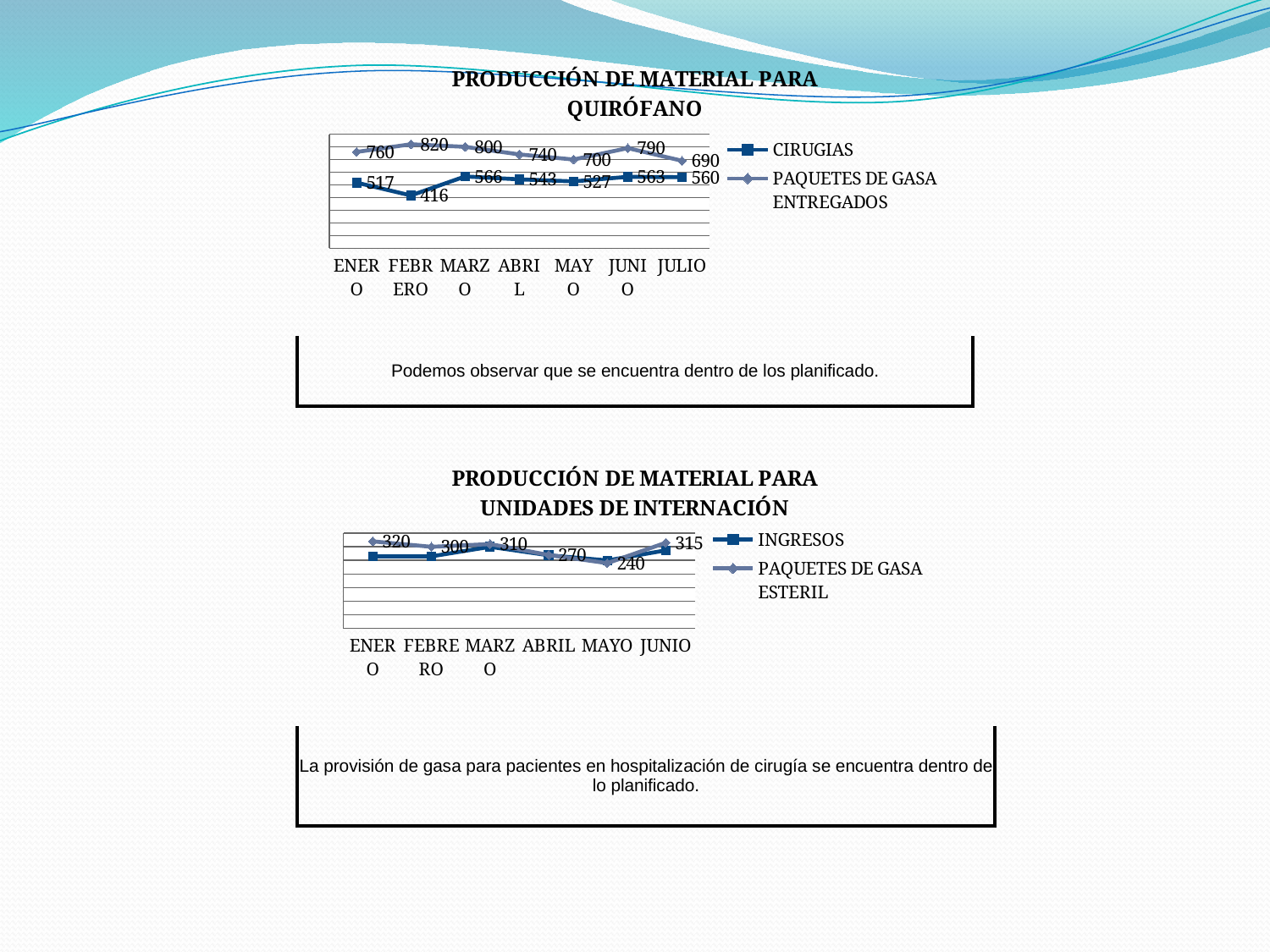
In the 'PRODUCCIÓN DE MATERIAL PARA QUIRÓFANO' chart, what is the value of PAQUETES DE GASA ENTREGADOS in FEBRERO? 820 In the 'PRODUCCIÓN DE MATERIAL PARA QUIRÓFANO' chart, what is the value of CIRUGIAS in FEBRERO? 416 In the 'PRODUCCIÓN DE MATERIAL PARA QUIRÓFANO' chart, what is the difference between PAQUETES DE GASA ENTREGADOS in ENERO and in JULIO? 70 In the 'PRODUCCIÓN DE MATERIAL PARA QUIRÓFANO' chart, which is larger in JUNIO: CIRUGIAS or PAQUETES DE GASA ENTREGADOS? PAQUETES DE GASA ENTREGADOS How many months are shown on the x axis of the 'PRODUCCIÓN DE MATERIAL PARA UNIDADES DE INTERNACIÓN' chart? 6 How many series does the legend of the 'PRODUCCIÓN DE MATERIAL PARA QUIRÓFANO' chart list? 2 What are the two legend entries of the 'PRODUCCIÓN DE MATERIAL PARA UNIDADES DE INTERNACIÓN' chart? INGRESOS and PAQUETES DE GASA ESTERIL How many months are shown on the x axis of the 'PRODUCCIÓN DE MATERIAL PARA QUIRÓFANO' chart? 7 In the 'PRODUCCIÓN DE MATERIAL PARA QUIRÓFANO' chart, which month has the highest value for PAQUETES DE GASA ENTREGADOS? FEBRERO In the 'PRODUCCIÓN DE MATERIAL PARA QUIRÓFANO' chart, which month has the lowest value for CIRUGIAS? FEBRERO In the 'PRODUCCIÓN DE MATERIAL PARA UNIDADES DE INTERNACIÓN' chart, which month has the lowest value for PAQUETES DE GASA ESTERIL? MAYO What kind of chart is the 'PRODUCCIÓN DE MATERIAL PARA QUIRÓFANO' chart? Line chart